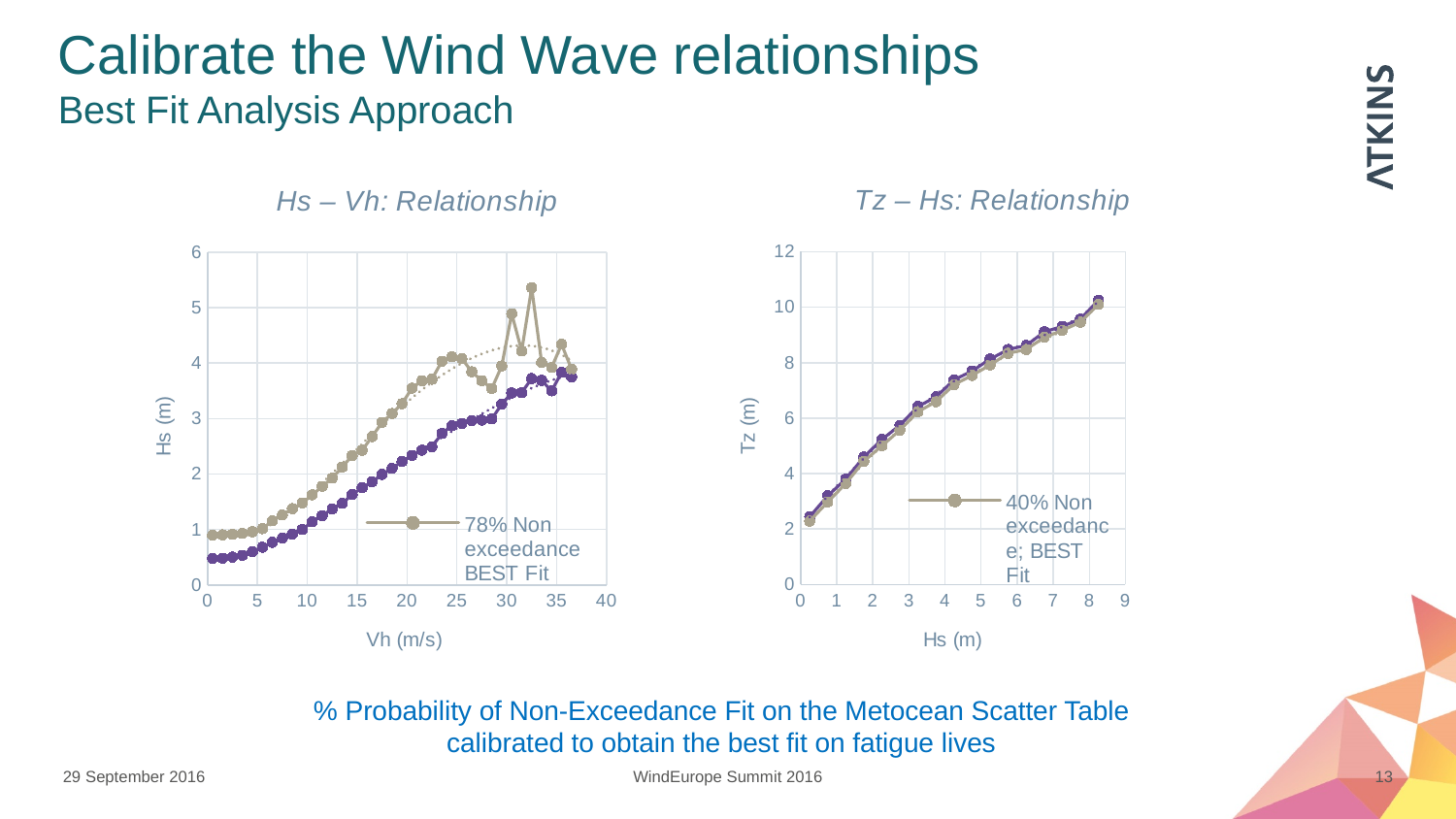
In the 'Hs – Vh: Relationship' chart, is the purple series value at Vh = 35 m/s greater or less than 4? less What type of chart is the 'Tz – Hs: Relationship' chart? Line chart In the 'Tz – Hs: Relationship' chart, is the Tz value at Hs = 1 m greater or less than 4? less In the 'Hs – Vh: Relationship' chart, does the purple series generally rise or fall as Vh increases from 0 to 30 m/s? Rise In the 'Tz – Hs: Relationship' chart, does Tz rise or fall as Hs increases along the x axis? Rise How many entries does the legend of the 'Tz – Hs: Relationship' chart list? 1 In the 'Hs – Vh: Relationship' chart, is the tan series value at Vh = 10 m/s greater or less than 1? greater What is the x-axis title of the 'Hs – Vh: Relationship' chart? Vh (m/s) What type of chart is the 'Hs – Vh: Relationship' chart? Line chart What is the legend entry shown on the 'Tz – Hs: Relationship' chart? 40% Non exceedance; BEST Fit